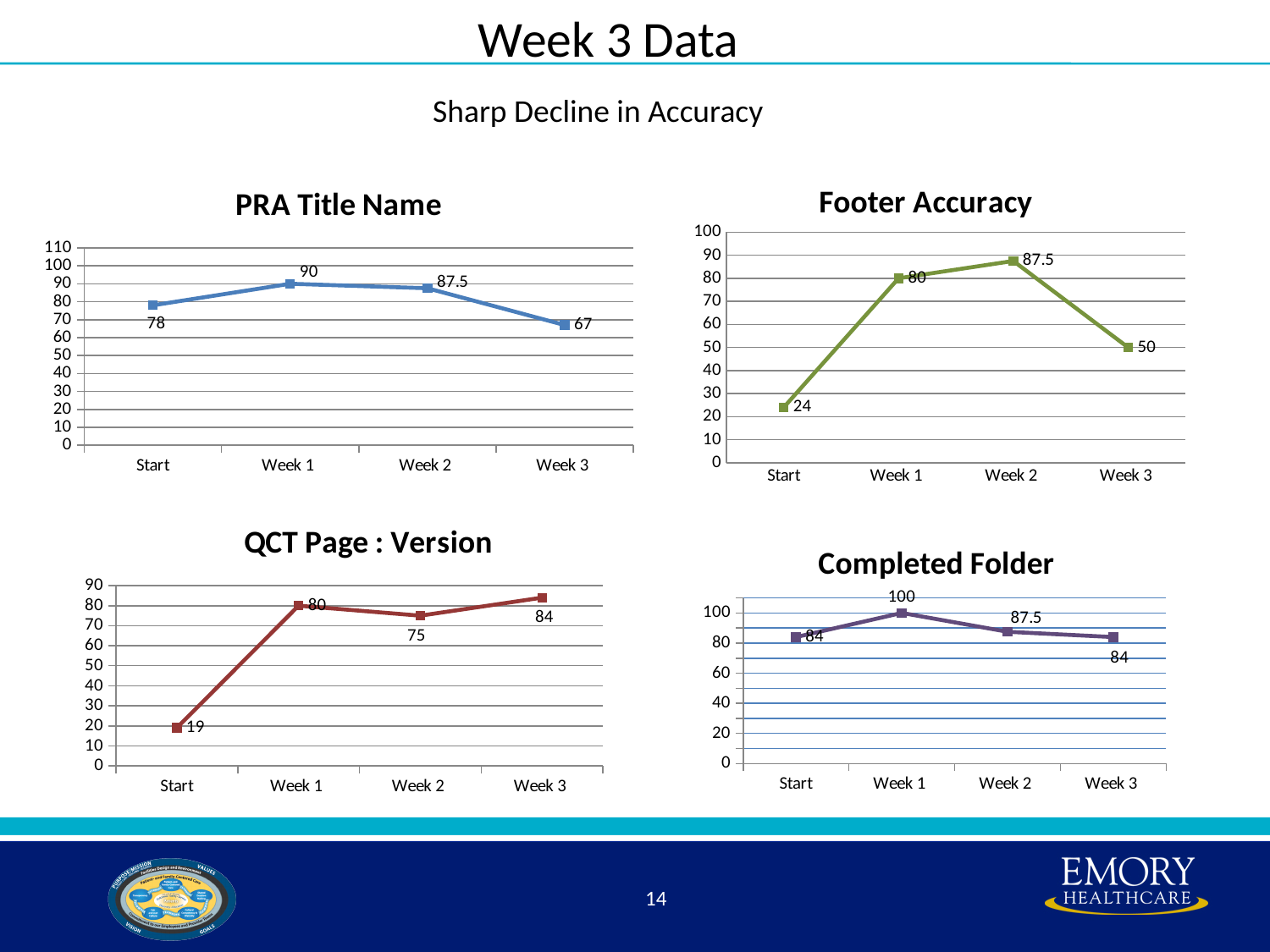
What type of chart is the 'Footer Accuracy' chart? Line chart How many data points are plotted in the 'Completed Folder' chart? 4 What is the subtitle shown below the slide title 'Week 3 Data'? Sharp Decline in Accuracy In the 'Completed Folder' chart, which point has the highest value? Week 1 In the 'Footer Accuracy' chart, what is the value at Start? 24 In the 'PRA Title Name' chart, what is the difference between the Week 1 value and the Week 3 value? 23 In the 'Footer Accuracy' chart, what is the difference between the Week 2 value and the Week 3 value? 37.5 In the 'Footer Accuracy' chart, does the value rise or fall from Week 2 to Week 3? Fall In the 'Footer Accuracy' chart, which point has the lowest value? Start In the 'PRA Title Name' chart, what is the value for Week 3? 67 In the 'QCT Page : Version' chart, which is larger, the value for Week 1 or the value for Week 3? Week 3 In the 'QCT Page : Version' chart, what is the value for Week 2? 75